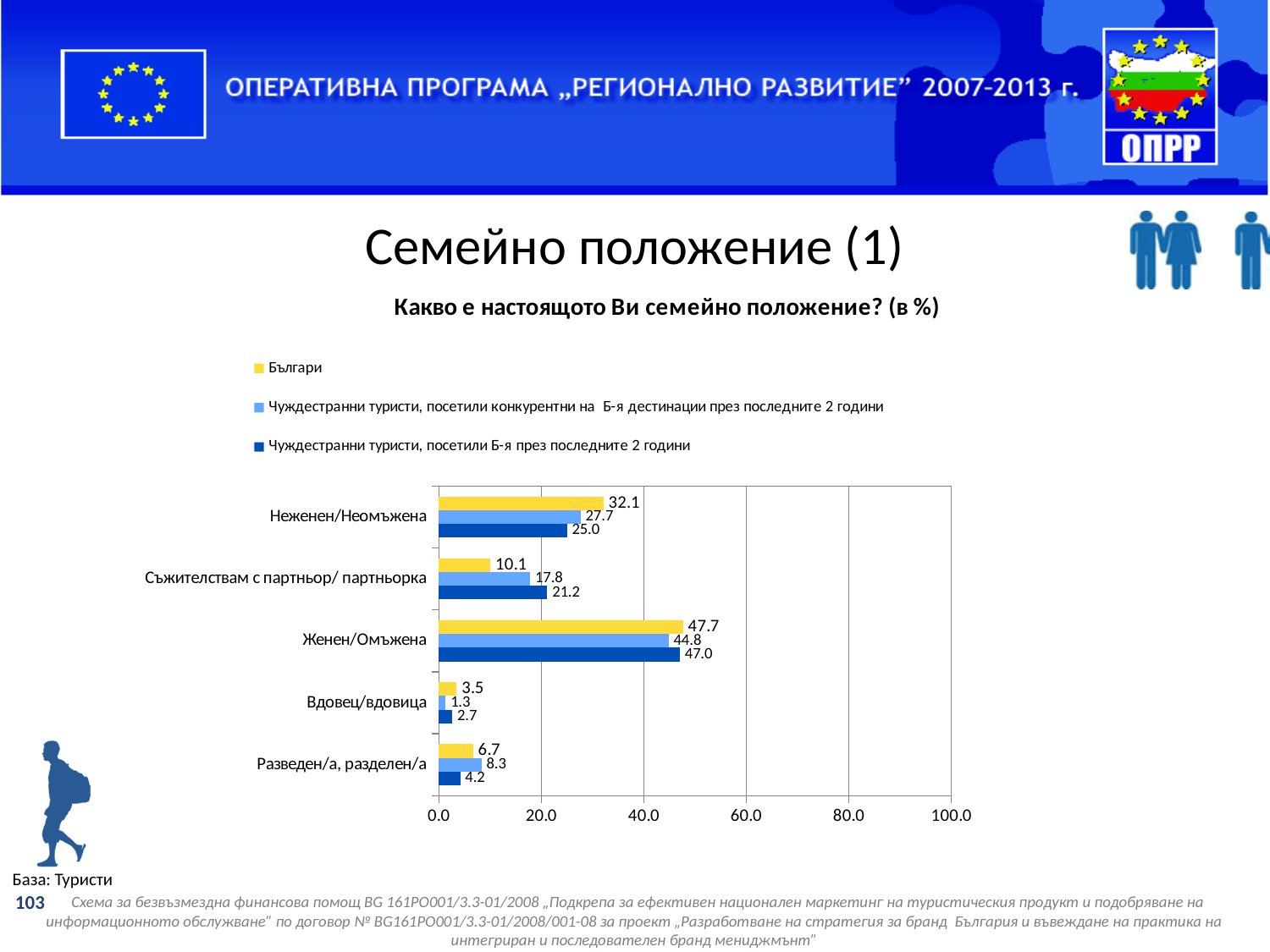
How many categories are shown on the chart? 5 What is the value for Чуждестранни туристи, посетили конкурентни на Б-я дестинации през последните 2 години in the Вдовец/вдовица category? 1.3 What is the difference between the Българи and Чуждестранни туристи, посетили Б-я през последните 2 години values in the Неженен/Неомъжена category? 7.1 How many series does the legend list? 3 What is the title of the chart? Какво е настоящото Ви семейно положение? (в %) Which category has the highest value for Българи? Женен/Омъжена What is the value for Чуждестранни туристи, посетили Б-я през последните 2 години in the Съжителствам с партньор/ партньорка category? 21.2 Is the value for Българи in the Неженен/Неомъжена category greater or less than 20.0? greater What type of chart is shown on the slide? Bar chart In the Разведен/а, разделен/а category, which series has the larger value: Българи or Чуждестранни туристи, посетили конкурентни на Б-я дестинации през последните 2 години? Чуждестранни туристи, посетили конкурентни на Б-я дестинации през последните 2 години Which category has the lowest value for Чуждестранни туристи, посетили Б-я през последните 2 години? Вдовец/вдовица What is the value for Българи in the Женен/Омъжена category? 47.7